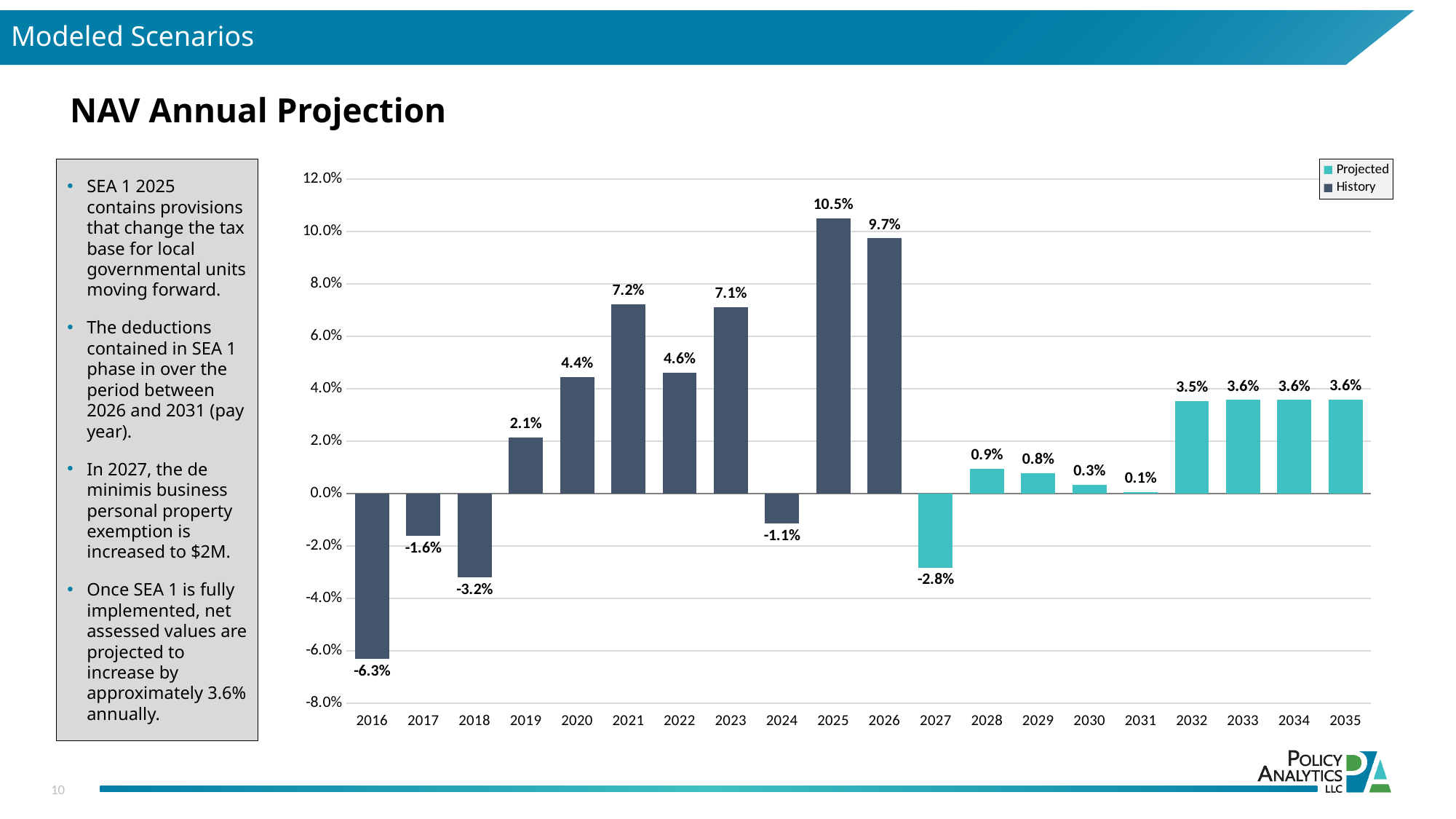
What is the difference between the values for 2025 and 2026? 0.8% Which year has the lowest value in the chart? 2016 Which year has the highest value in the chart? 2025 How many series does the legend list? 2 How many years are shown on the x axis of the chart? 20 What is the NAV annual projection value for 2025? 10.5% What is the value shown for 2016? -6.3% Which year has a larger value, 2021 or 2023? 2021 What are the two series named in the legend? Projected and History What is the value shown for 2027? -2.8% What kind of chart is shown on the slide? Bar chart